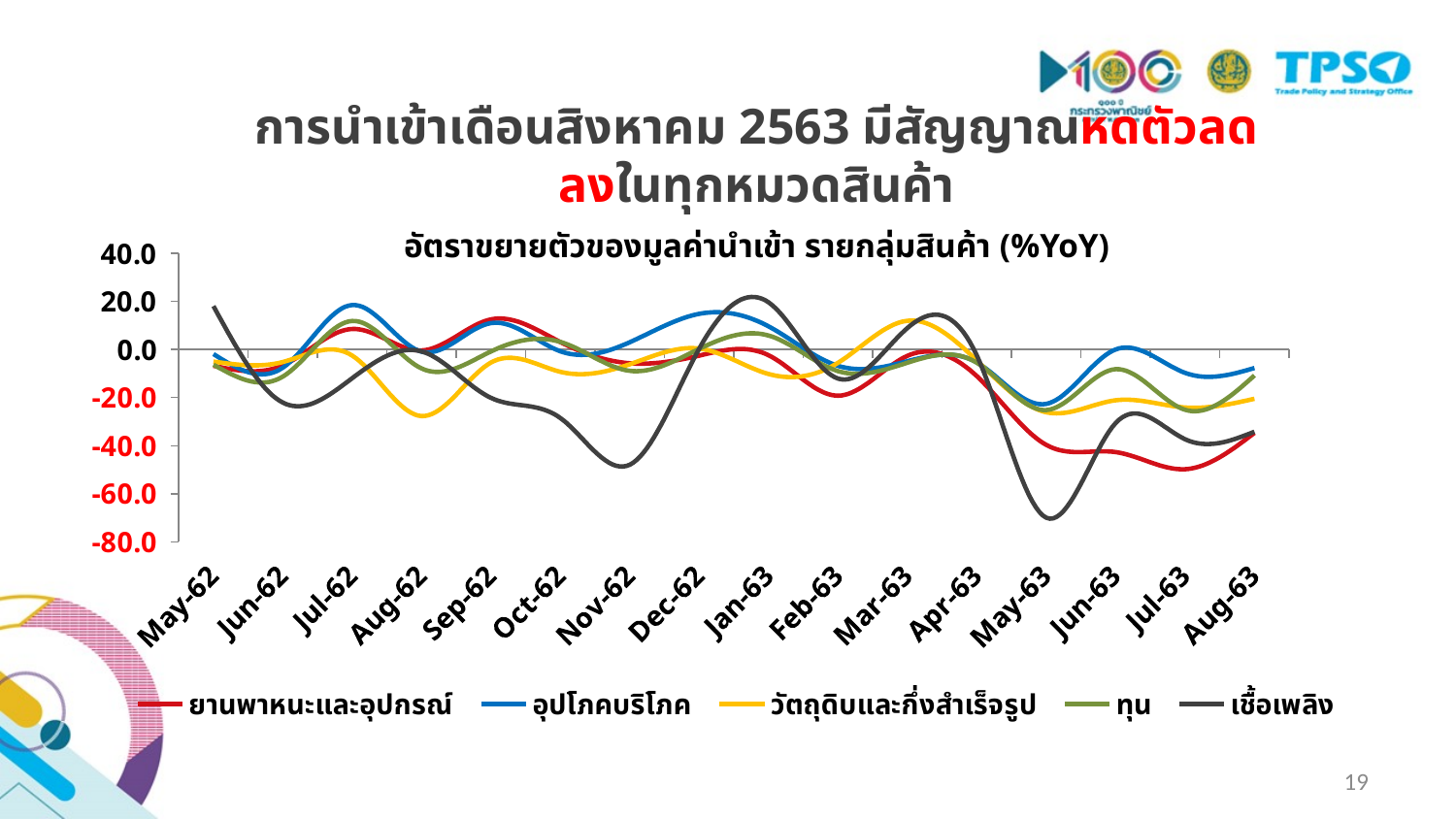
How many series does the legend list? 5 What kind of chart is shown on the slide? Line chart What is the title of the chart? อัตราขยายตัวของมูลค่านำเข้า รายกลุ่มสินค้า (%YoY) Is the value for อุปโภคบริโภค in Jul-62 greater or less than 0? greater Which series reaches the lowest value anywhere on the chart? เชื้อเพลิง Is the value for ยานพาหนะและอุปกรณ์ in Jul-63 greater or less than -40? less What is the first month shown on the x axis? May-62 Is the value for เชื้อเพลิง in May-63 greater or less than -60? less How many months are shown along the x axis? 16 In May-63, which is higher: เชื้อเพลิง or อุปโภคบริโภค? อุปโภคบริโภค Does the เชื้อเพลิง line rise or fall from Jan-63 to May-63? fall